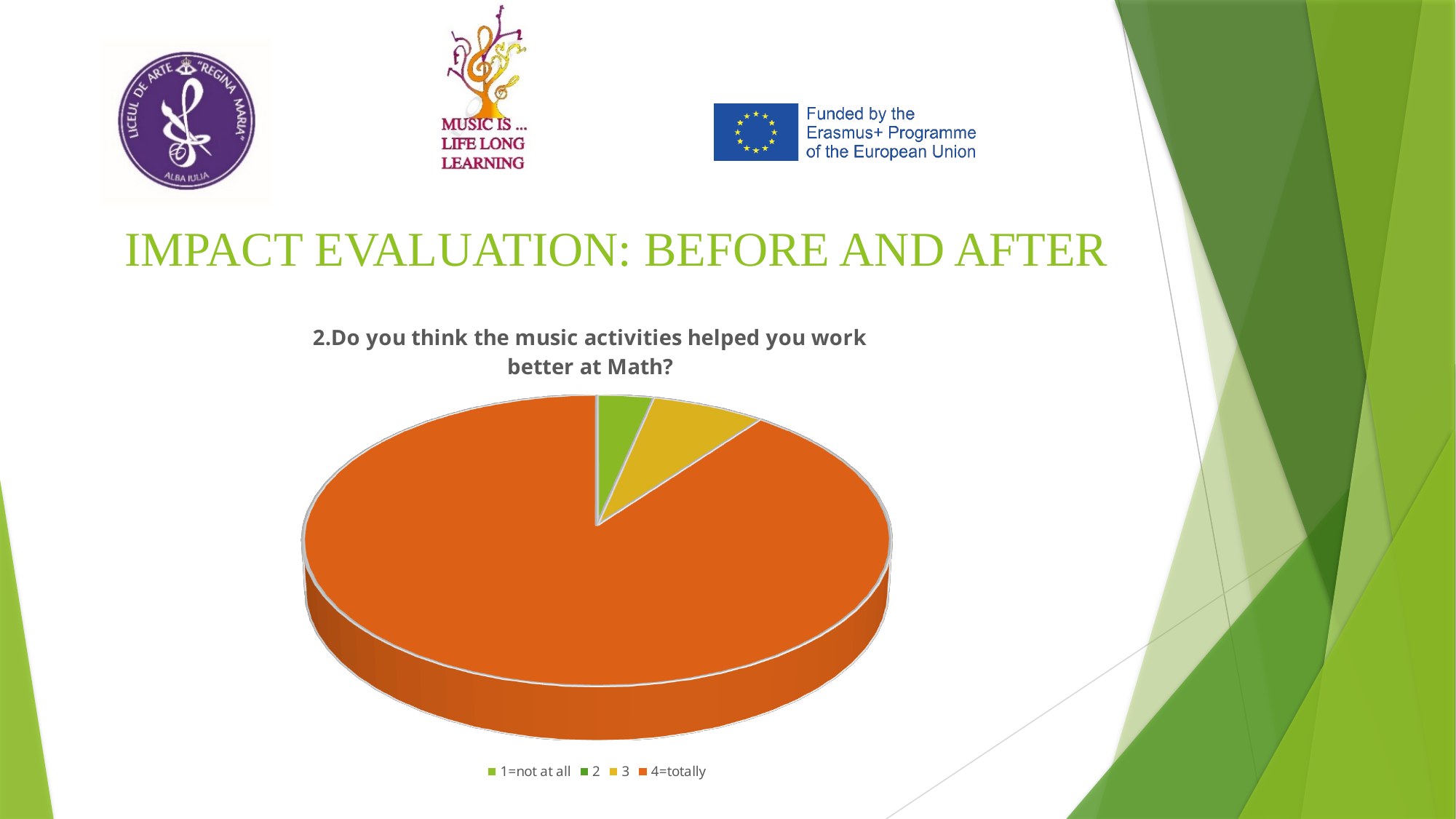
What kind of chart is shown on the slide? pie chart Which is larger, the slice for 4=totally or the slice for 3? 4=totally How many categories does the legend list? 4 What colour is the slice for 4=totally? orange Which category has the largest slice of the pie? 4=totally What is the title of the chart? 2.Do you think the music activities helped you work better at Math? Does the slice for 4=totally take up more or less than half of the pie? more Which is larger, the slice for 3 or the slice for 1=not at all? 3